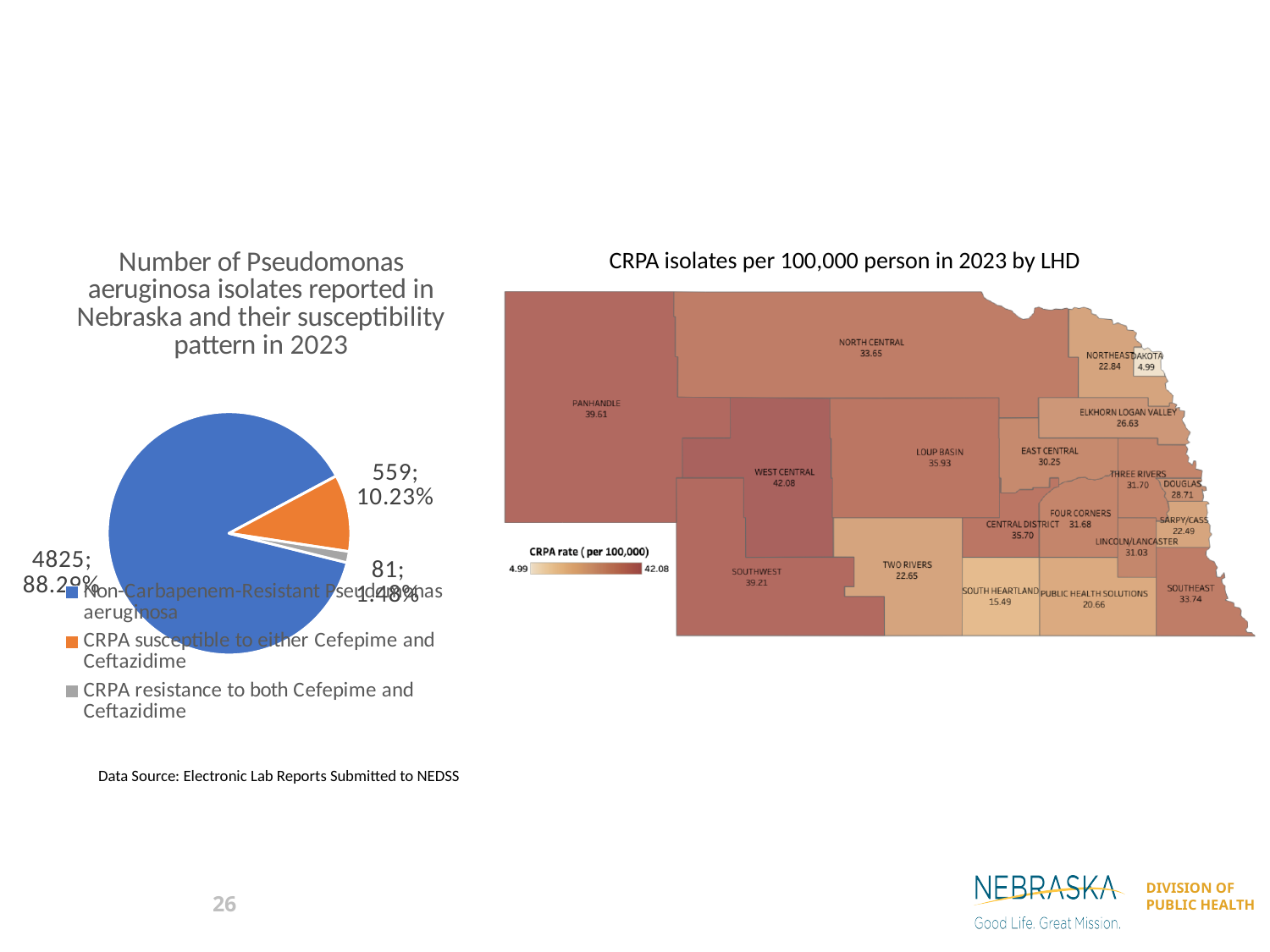
In the map on the right, which LHD has the lowest CRPA rate per 100,000? Dakota In the pie chart on the left, which category has the largest slice? Non-Carbapenem-Resistant Pseudomonas aeruginosa In the pie chart on the left, how many isolates are CRPA resistance to both Cefepime and Ceftazidime? 81 What kind of chart is the one on the left titled "Number of Pseudomonas aeruginosa isolates reported in Nebraska and their susceptibility pattern in 2023"? Pie chart In the map on the right, which has the higher CRPA rate, Panhandle or Southwest? Panhandle In the pie chart on the left, what share of isolates are CRPA susceptible to either Cefepime and Ceftazidime? 10.23% In the pie chart on the left, which category has the smallest slice? CRPA resistance to both Cefepime and Ceftazidime In the pie chart on the left, how many isolates are Non-Carbapenem-Resistant Pseudomonas aeruginosa? 4825 In the pie chart on the left, what is the difference in isolate counts between CRPA susceptible to either Cefepime and Ceftazidime and CRPA resistance to both Cefepime and Ceftazidime? 478 In the map on the right titled "CRPA isolates per 100,000 person in 2023 by LHD", what is the CRPA rate for West Central? 42.08 In the pie chart on the left, how many isolates are CRPA susceptible to either Cefepime and Ceftazidime? 559 In the pie chart on the left, how many categories does the legend list? 3